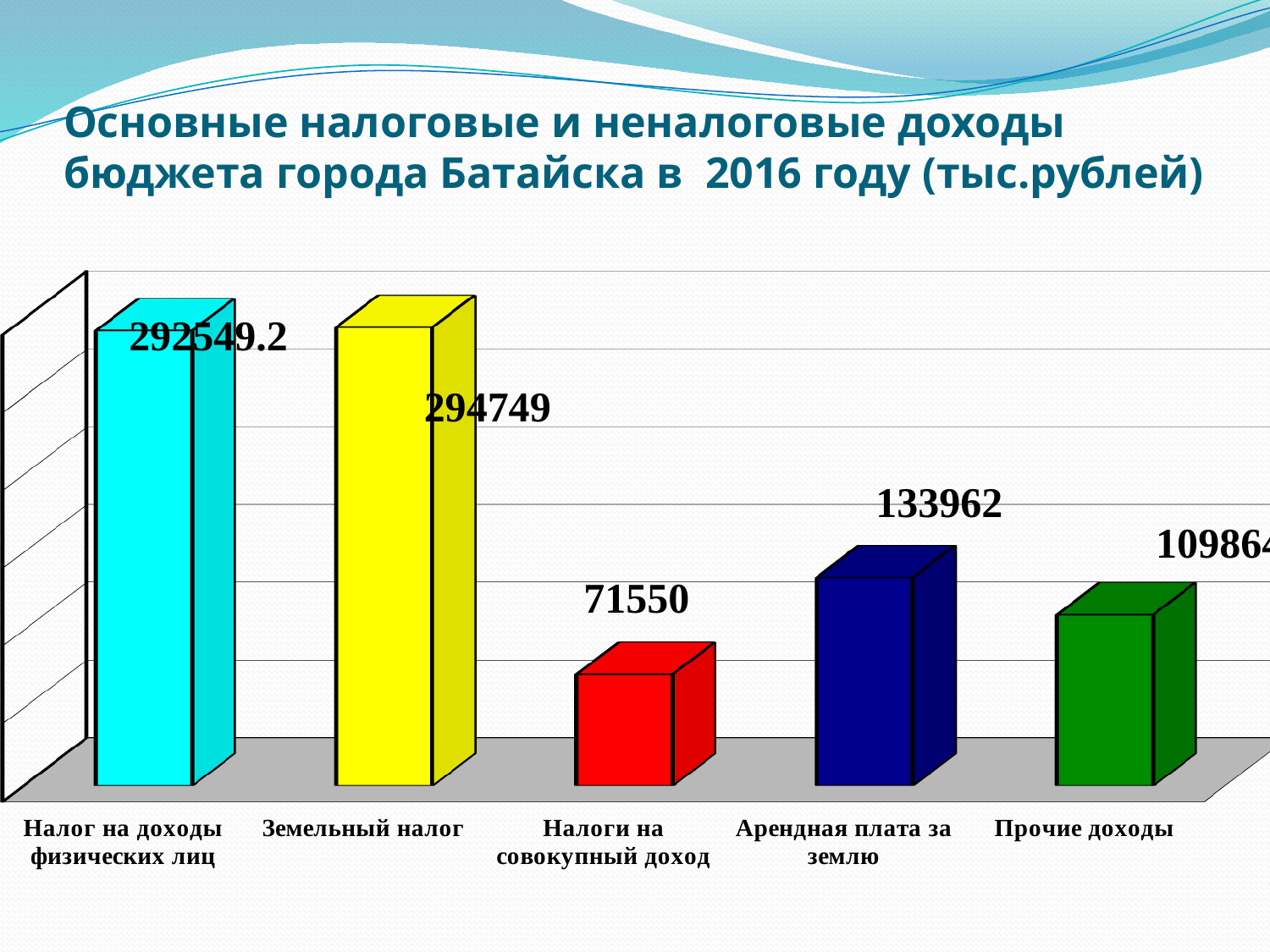
What is the difference between the values for Земельный налог and Налог на доходы физических лиц? 2199.8 How many categories are shown in the chart? 5 What is the value for Налоги на совокупный доход? 71550 What kind of chart is shown on the slide? Bar chart What is the difference between the values for Арендная плата за землю and Налоги на совокупный доход? 62412 Which category has the highest value? Земельный налог Which is larger, the value for Арендная плата за землю or the value for Налоги на совокупный доход? Арендная плата за землю In what units are the values in the chart expressed, according to the title? тыс.рублей What is the value for Земельный налог? 294749 What is the value for Арендная плата за землю? 133962 What is the value for Налог на доходы физических лиц? 292549.2 Which category has the lowest value? Налоги на совокупный доход